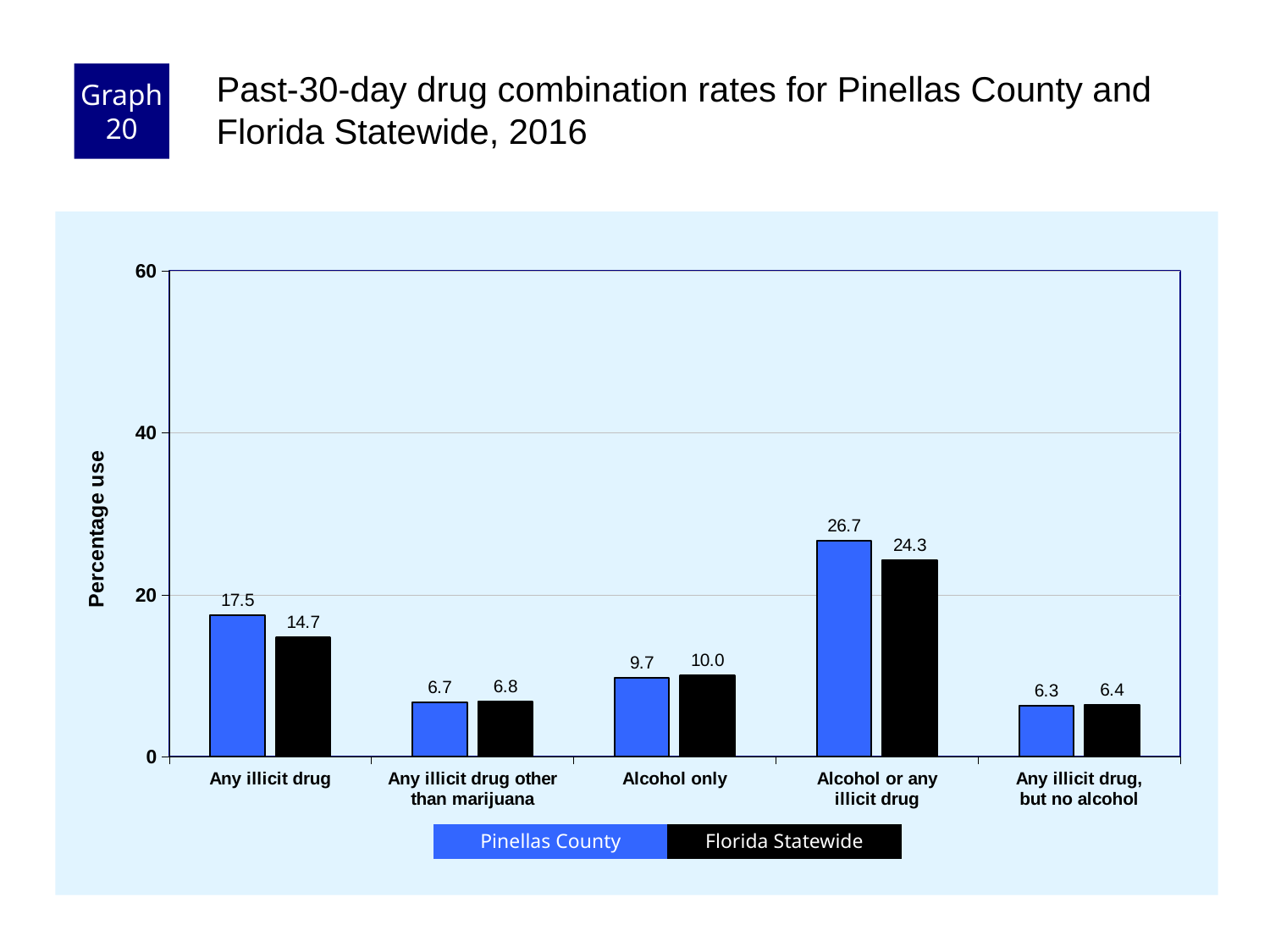
What is the difference between the Pinellas County and Florida Statewide values for Any illicit drug? 2.8 What kind of chart is shown on the slide? bar chart What is the Florida Statewide value for Alcohol or any illicit drug? 24.3 Is the Pinellas County value for Alcohol or any illicit drug greater or less than 20? greater Which category has the highest Pinellas County value? Alcohol or any illicit drug What is the difference between the Pinellas County and Florida Statewide values for Alcohol or any illicit drug? 2.4 How many categories are shown on the x axis? 5 Which category has the lowest Florida Statewide value? Any illicit drug, but no alcohol What is the Florida Statewide value for Alcohol only? 10.0 What is the Pinellas County value for Any illicit drug? 17.5 How many series does the legend list? 2 Which is larger for Any illicit drug: the Pinellas County value or the Florida Statewide value? Pinellas County